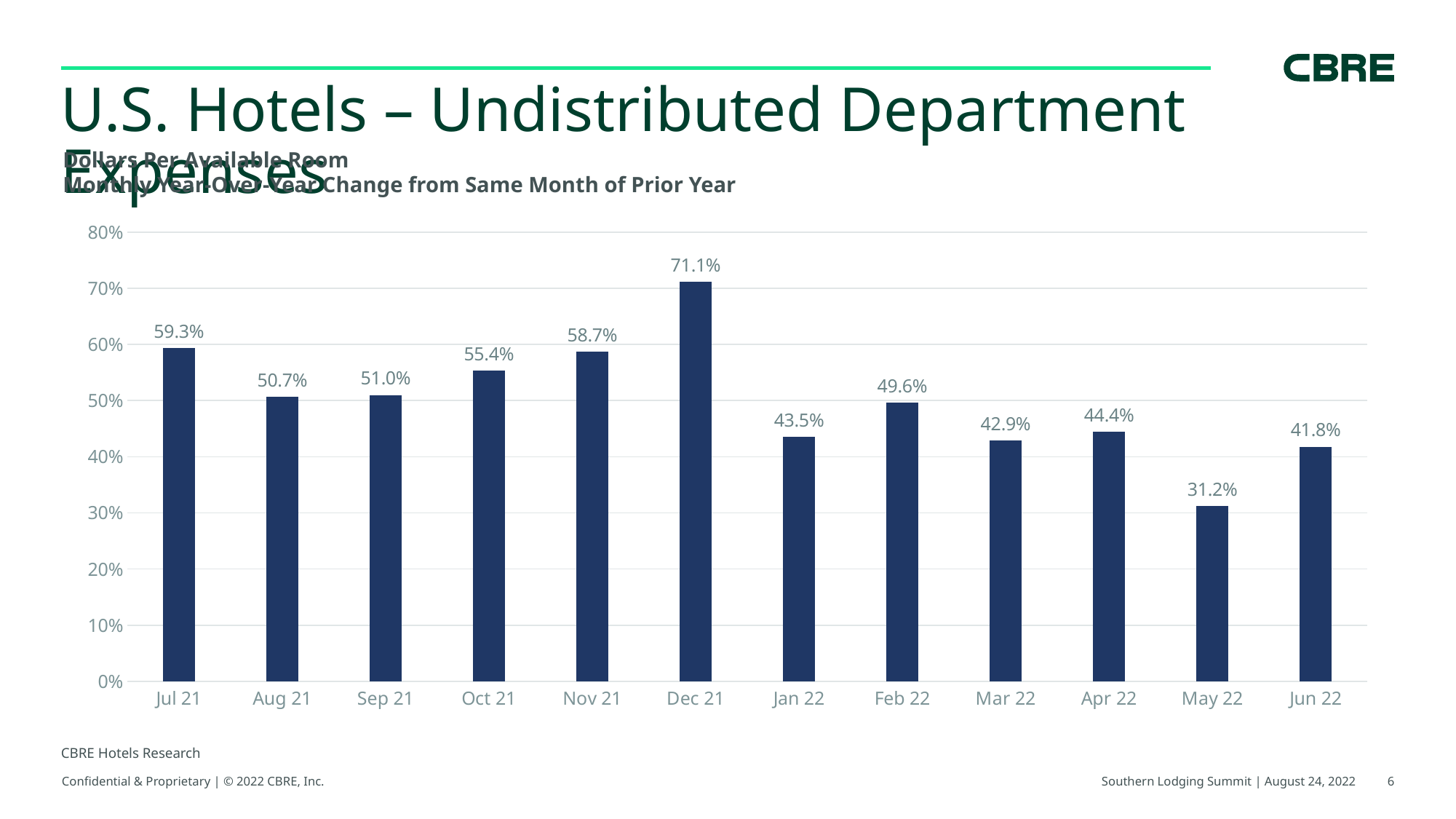
What is the difference between the values for Jul 21 and Jun 22? 17.5% Which month has the lowest value? May 22 Is the value for Apr 22 greater or less than 50%? less What is the value for Dec 21? 71.1% Which month has the highest value? Dec 21 What is the value for May 22? 31.2% Which is larger, the value for Feb 22 or the value for Mar 22? Feb 22 What is the chart's subtitle below 'Dollars Per Available Room'? Monthly Year-Over-Year Change from Same Month of Prior Year How many months are shown on the x axis? 12 What is the difference between the values for Dec 21 and Nov 21? 12.4% What is the value for Jan 22? 43.5% What kind of chart is shown on the slide? bar chart